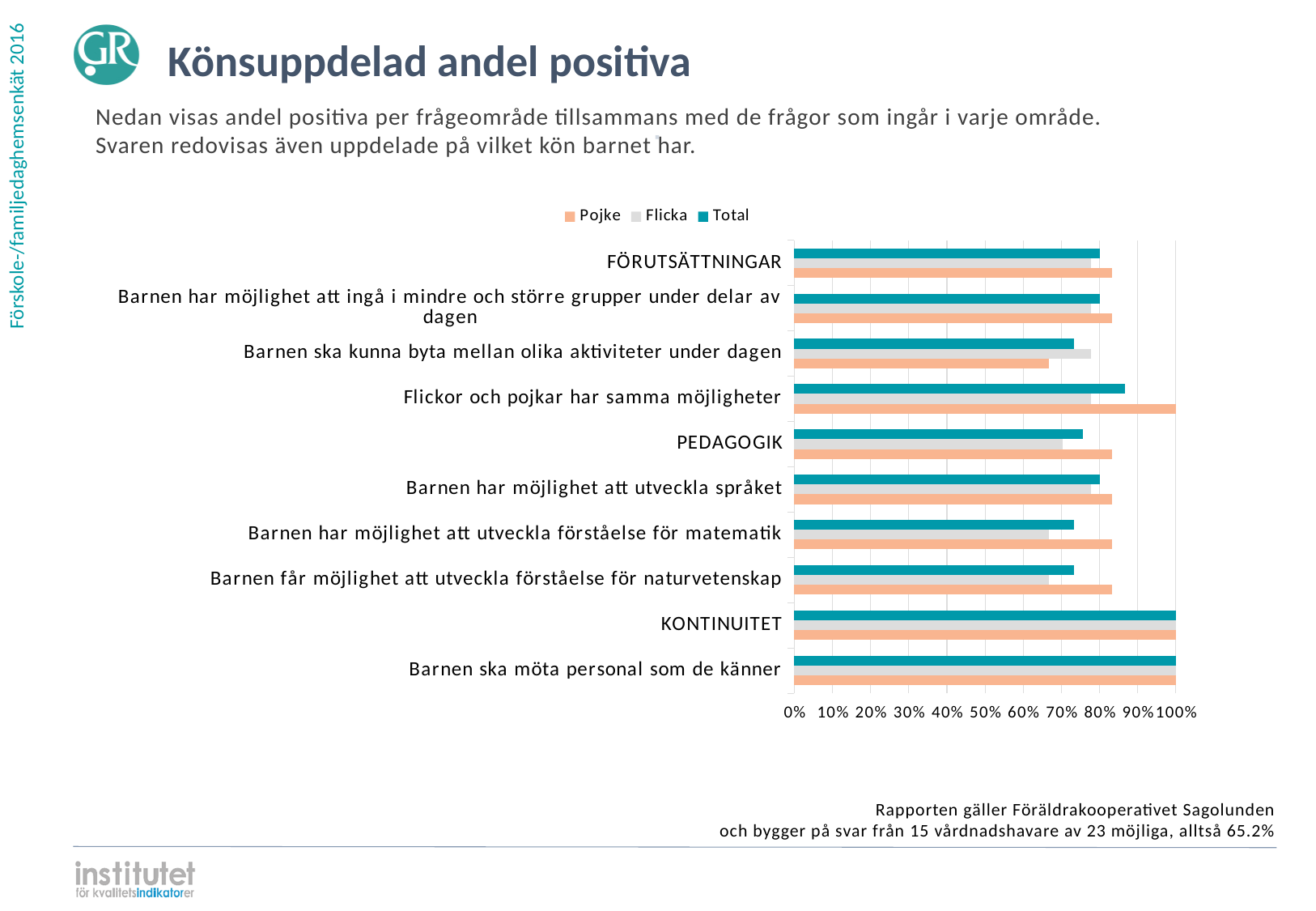
For 'Flickor och pojkar har samma möjligheter', which is larger: the Pojke value or the Flicka value? Pojke What is the Pojke value for 'Flickor och pojkar har samma möjligheter'? 100% What is the Pojke value for 'Barnen ska möta personal som de känner'? 100% For 'Barnen ska kunna byta mellan olika aktiviteter under dagen', which is larger: the Pojke value or the Flicka value? Flicka How many series does the legend list? 3 How many categories are plotted on the y axis of the chart? 10 What kind of chart is shown on the slide? bar chart Is the Pojke value for 'Barnen ska kunna byta mellan olika aktiviteter under dagen' greater or less than 70%? less Is the Flicka value for 'Barnen har möjlighet att utveckla förståelse för matematik' greater or less than 70%? less Which series is shown in orange in the legend? Pojke What is the Total value for KONTINUITET? 100% Is the Total value for 'Flickor och pojkar har samma möjligheter' greater or less than 80%? greater